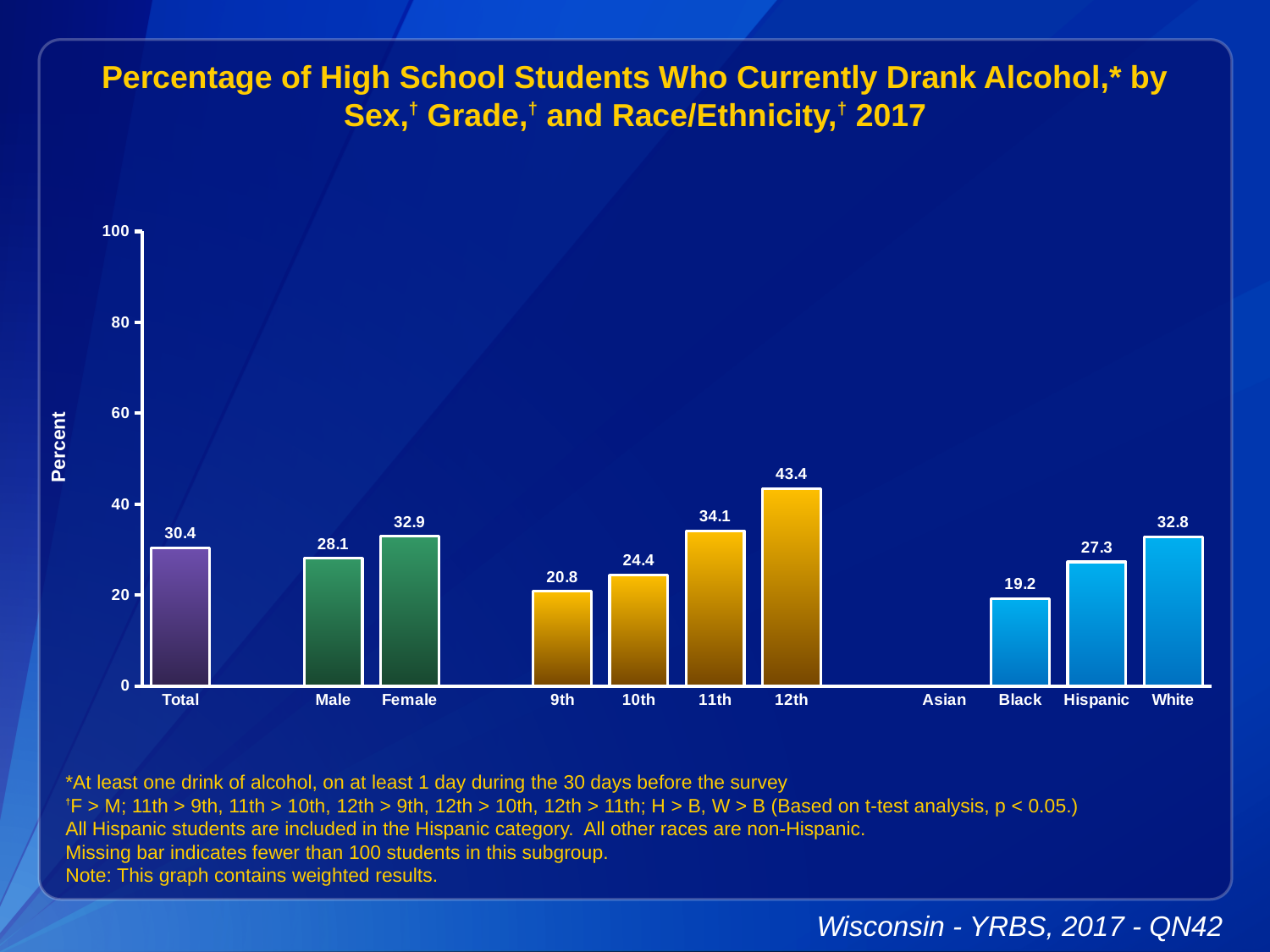
Which category on the x axis has no bar shown? Asian What is the value for Female? 32.9 Which category with a bar has the lowest value? Black What kind of chart is shown on the slide? bar chart Which is larger, the value for Hispanic or the value for White? White What is the value for Total? 30.4 What is the difference between the 12th and 9th grade values? 22.6 What is the difference between the Female and Male values? 4.8 What is the value for 12th grade? 43.4 What is the value for Black students? 19.2 Is the value for 11th grade greater or less than 40? less Which category has the highest value? 12th